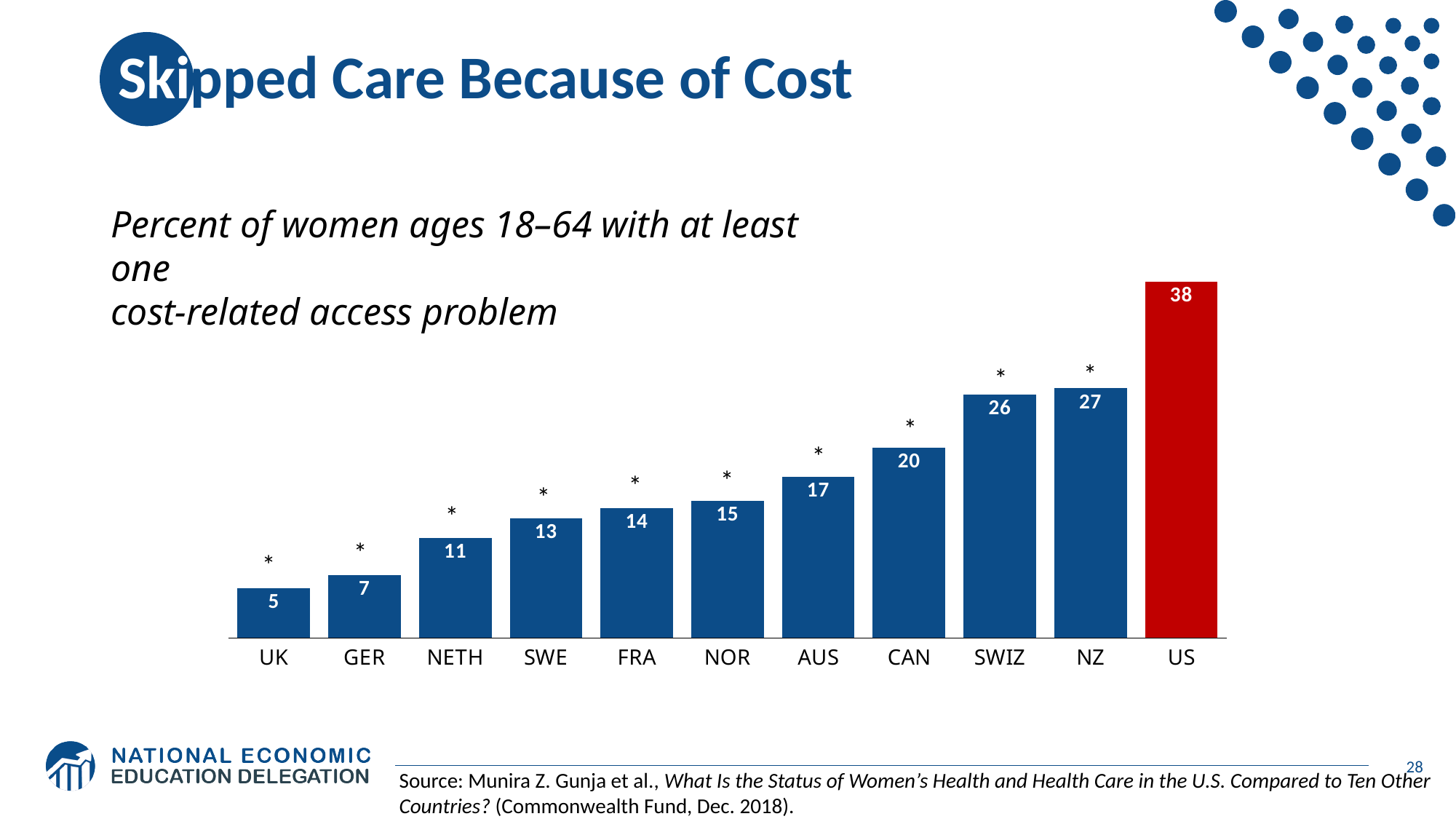
Which bar is coloured red rather than blue? US What is the value for the US? 38 Which is larger, the value for AUS or the value for FRA? AUS Which country has the lowest value? UK What is the difference between the values for the US and NZ? 11 Which country has the highest value? US What is the difference between the values for SWIZ and UK? 21 Do the values rise or fall from left to right along the x axis? Rise What kind of chart is shown on the slide? Bar chart What is the value for Canada (CAN)? 20 How many countries are shown on the chart? 11 What is the value for Germany (GER)? 7